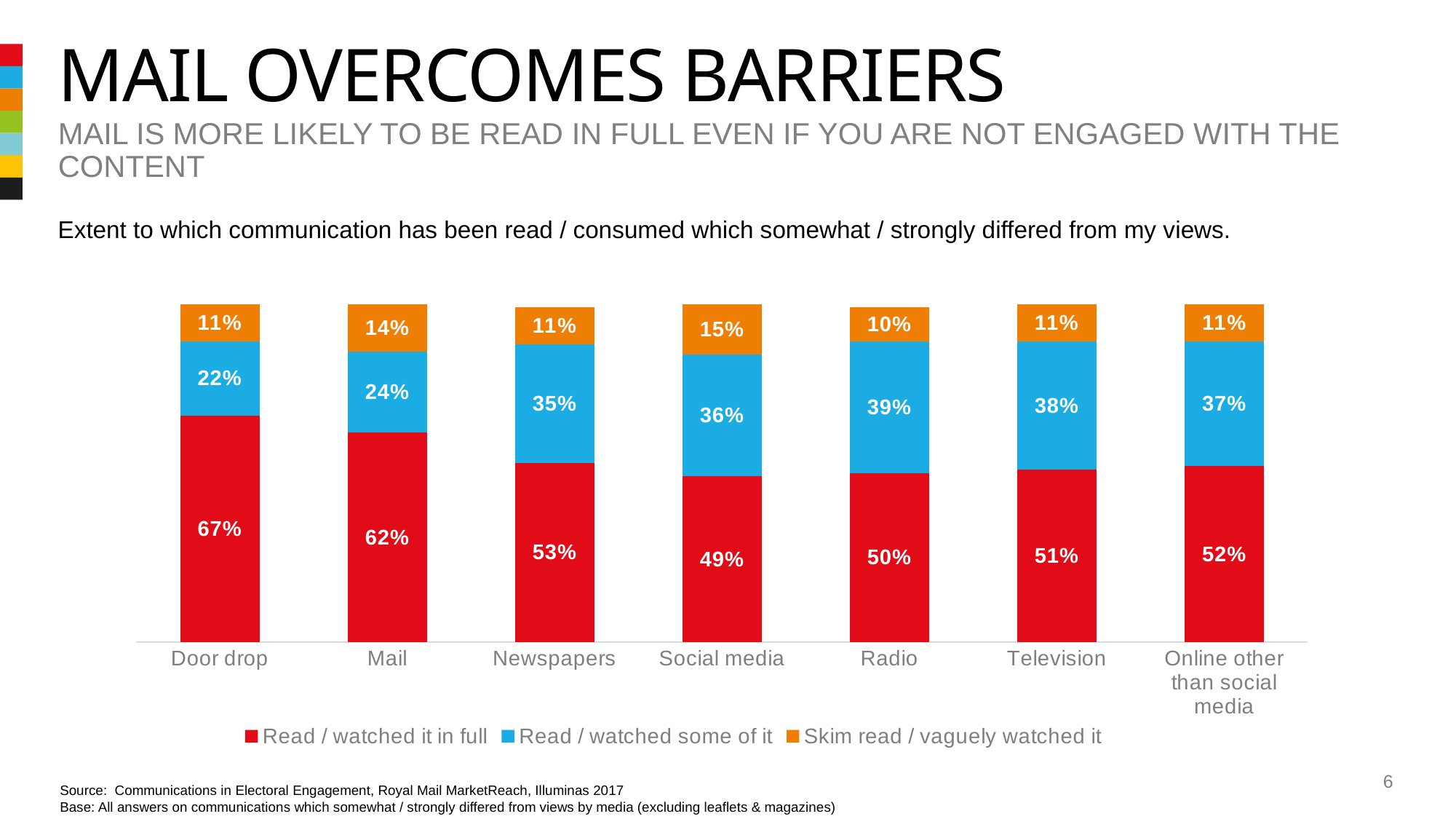
Which has a larger 'Read / watched some of it' value, Television or Mail? Television What is the 'Read / watched some of it' value for Radio? 39% How many categories are shown on the x axis? 7 Which category has the highest 'Read / watched it in full' value? Door drop What is the 'Skim read / vaguely watched it' value for Social media? 15% What is the difference between the 'Read / watched it in full' values for Door drop and Mail? 5% Which category has the lowest 'Read / watched it in full' value? Social media How many series does the legend list? 3 What is the total of the stacked bar for Newspapers? 99% Which colour represents 'Skim read / vaguely watched it' in the legend? Orange What kind of chart is shown on the slide? Stacked bar chart What percentage of Door drop communications were read / watched in full? 67%